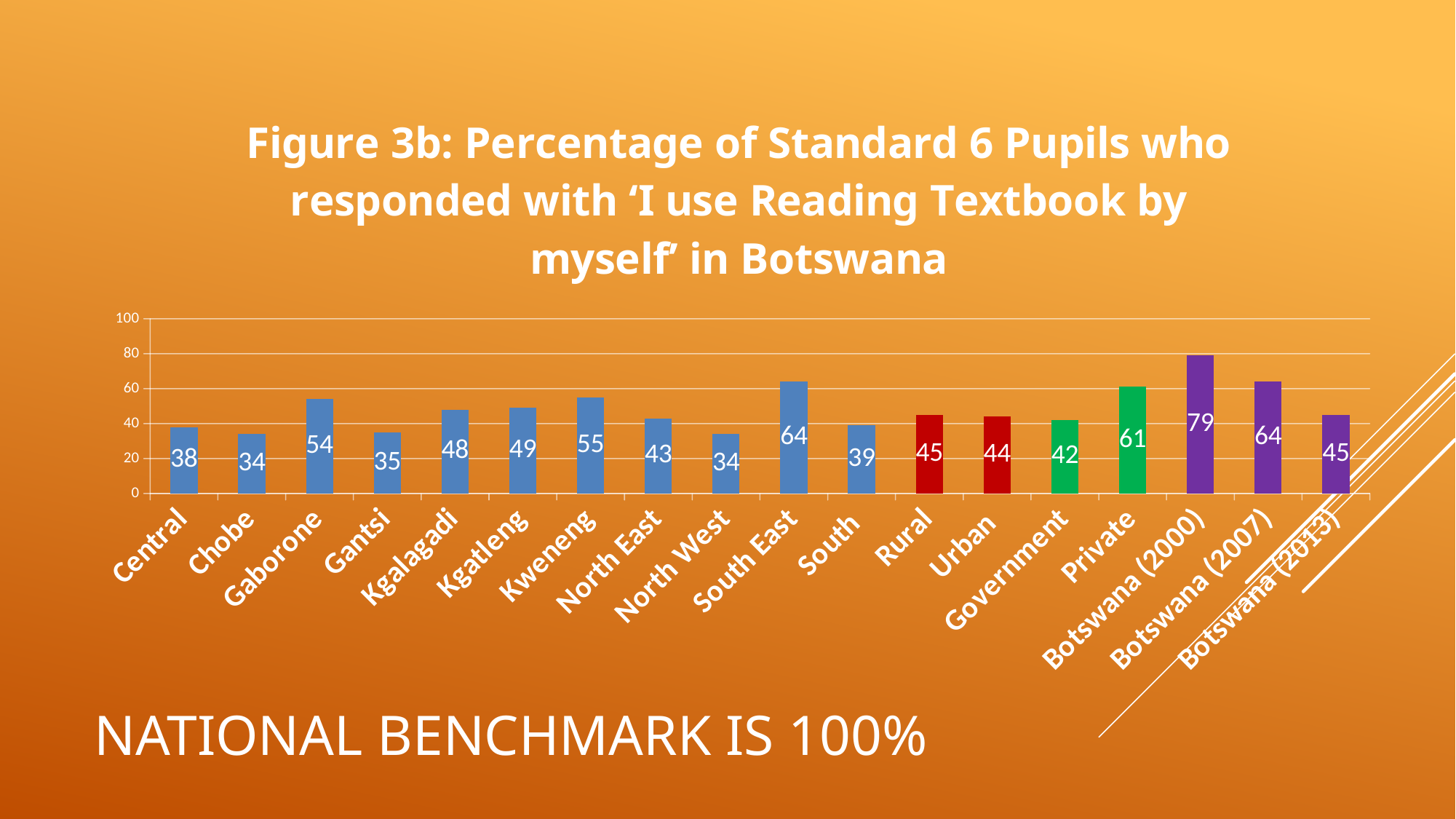
Which category has the highest value? Botswana (2000) What is the value for Botswana (2000)? 79 What is the difference between the values for Botswana (2000) and Botswana (2013)? 34 Which is larger, the value for Rural or the value for Urban? Rural How many categories are shown on the x axis? 18 What colour are the bars for the three Botswana year categories? Purple What is the difference between the Private and Government values? 19 What kind of chart is shown on the slide? Bar chart What is the value for Gaborone? 54 Which is larger, the value for Kweneng or the value for Gaborone? Kweneng What percentage is shown for Private schools? 61 What is the value for South East? 64